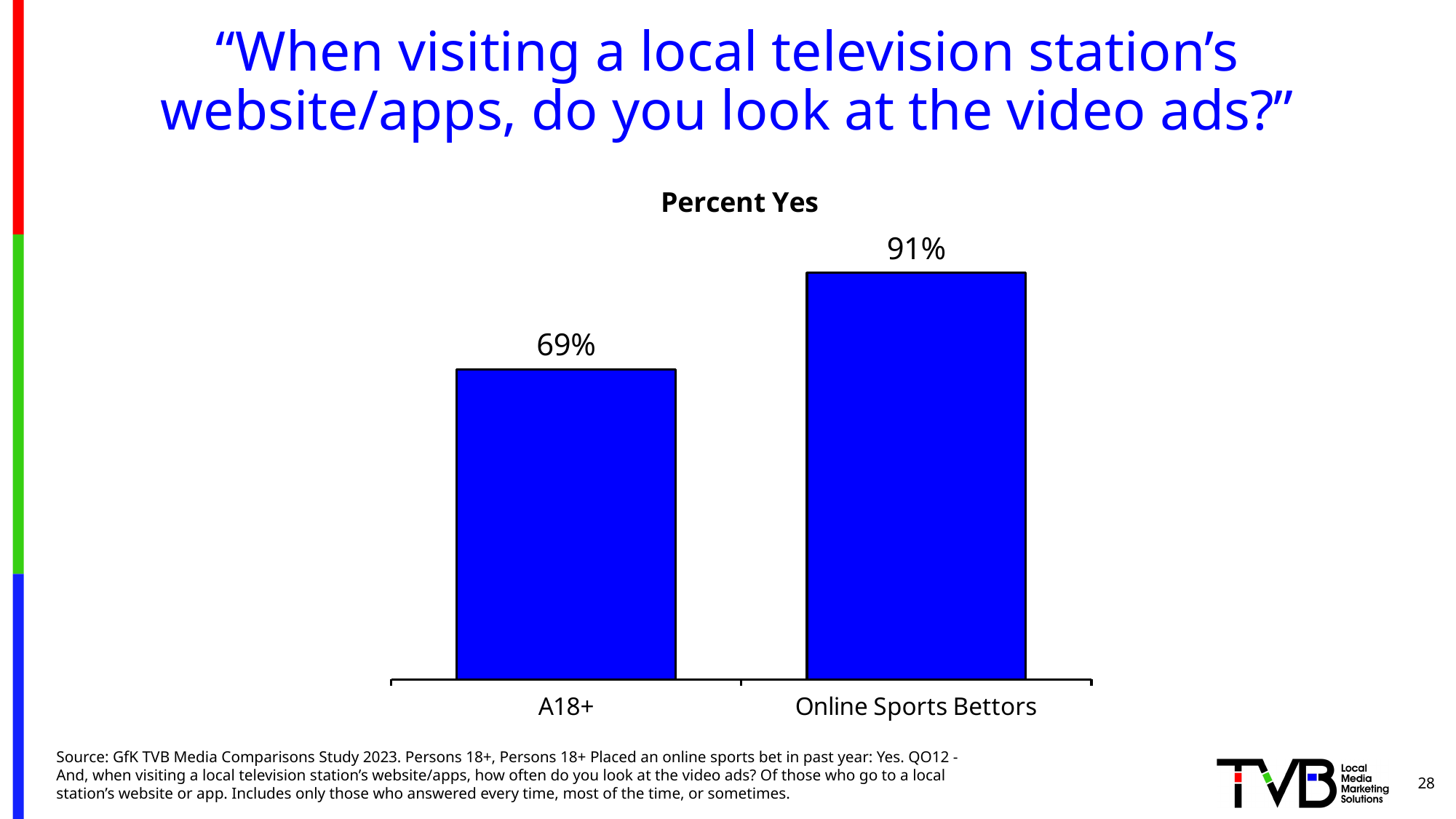
What is the title of the chart? Percent Yes Which category has the highest Percent Yes value? Online Sports Bettors What is the Percent Yes value for Online Sports Bettors? 91% What colour are the bars in the chart? Blue What kind of chart is shown on the slide? Bar chart What is the Percent Yes value for A18+? 69% How many categories are shown in the chart? 2 What is the difference between the Percent Yes values for Online Sports Bettors and A18+? 22% Which is larger, the Percent Yes value for A18+ or for Online Sports Bettors? Online Sports Bettors Which category has the lowest Percent Yes value? A18+